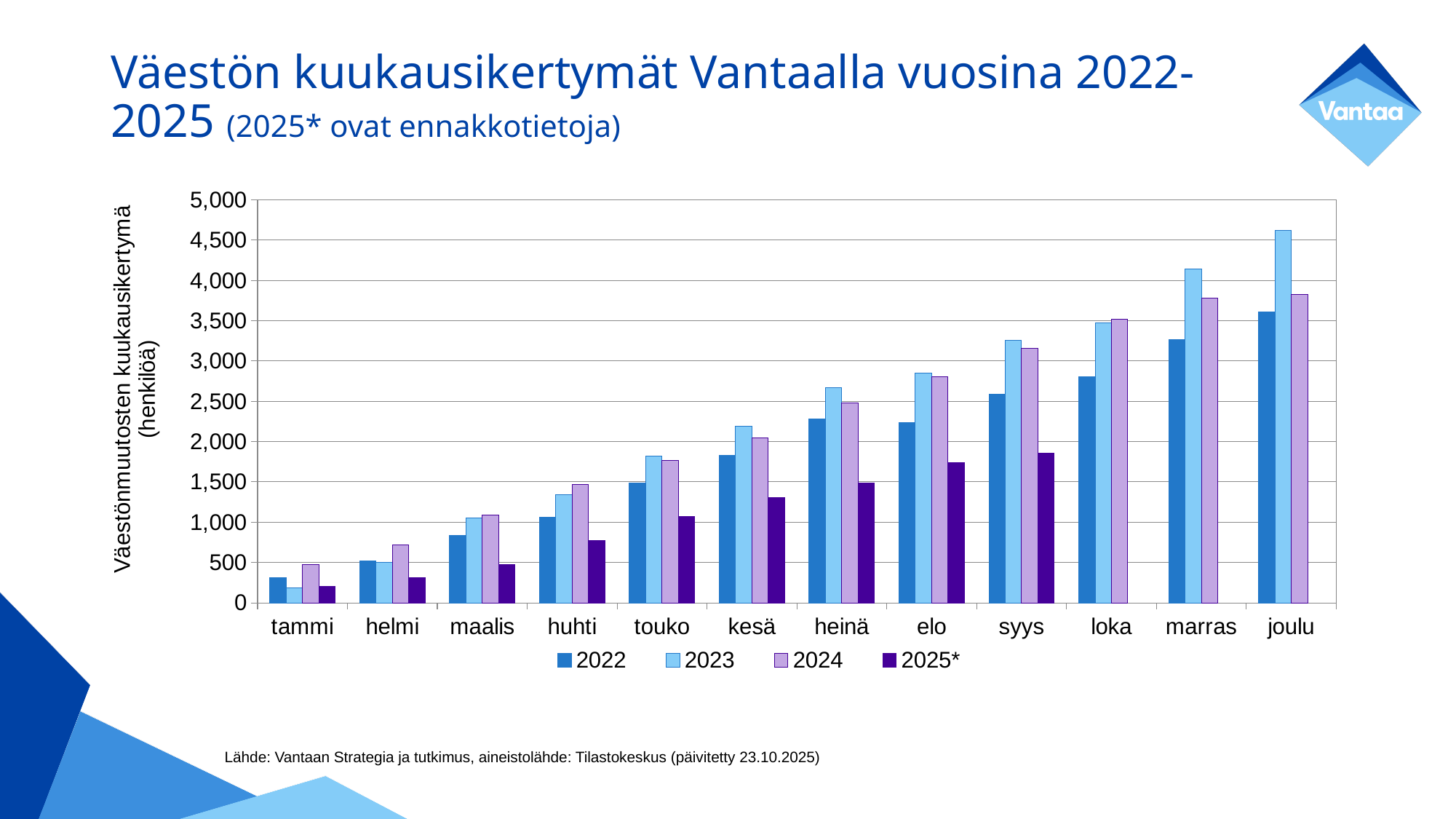
What kind of chart is shown on the slide? bar chart Which series has the highest value in joulu? 2023 In helmi, which is larger: the 2023 value or the 2024 value? 2024 Which month has the highest value for the 2023 series? joulu Do the values for the 2022 series rise or fall from tammi to joulu? rise Which month has the lowest value for the 2025* series? tammi How many months are shown on the x axis? 12 What is the label of the y axis? Väestönmuutosten kuukausikertymä (henkilöä) Is the 2023 value for joulu greater or less than 4,000? greater Is the 2025* value for huhti greater or less than 1,000? less In tammi, which is larger: the 2022 value or the 2023 value? 2022 How many series does the legend list? 4